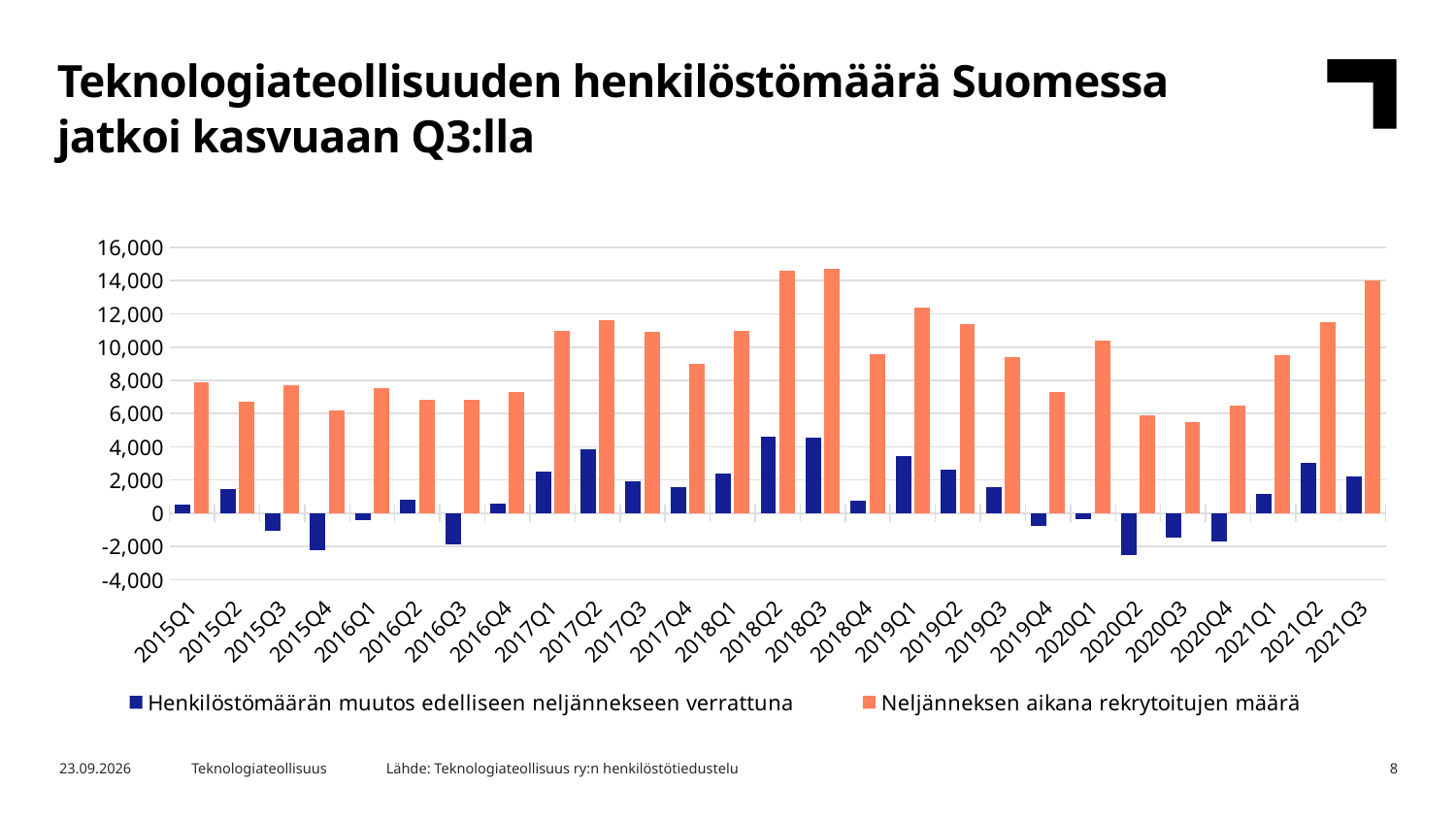
How many series does the legend list? 2 Is the value of 'Neljänneksen aikana rekrytoitujen määrä' for 2021Q3 greater or less than 12,000? greater Do the values of 'Neljänneksen aikana rekrytoitujen määrä' rise or fall from 2020Q3 to 2021Q3? rise Is the value of 'Neljänneksen aikana rekrytoitujen määrä' for 2019Q1 greater or less than 10,000? greater Which is larger for 'Henkilöstömäärän muutos edelliseen neljännekseen verrattuna': 2017Q2 or 2017Q3? 2017Q2 Which is larger for 'Neljänneksen aikana rekrytoitujen määrä': 2018Q2 or 2020Q2? 2018Q2 Is the value of 'Henkilöstömäärän muutos edelliseen neljännekseen verrattuna' for 2018Q2 greater or less than 4,000? greater How many quarters are shown on the x axis? 27 What kind of chart is shown on the slide? bar chart Which colour represents 'Neljänneksen aikana rekrytoitujen määrä' in the chart? orange